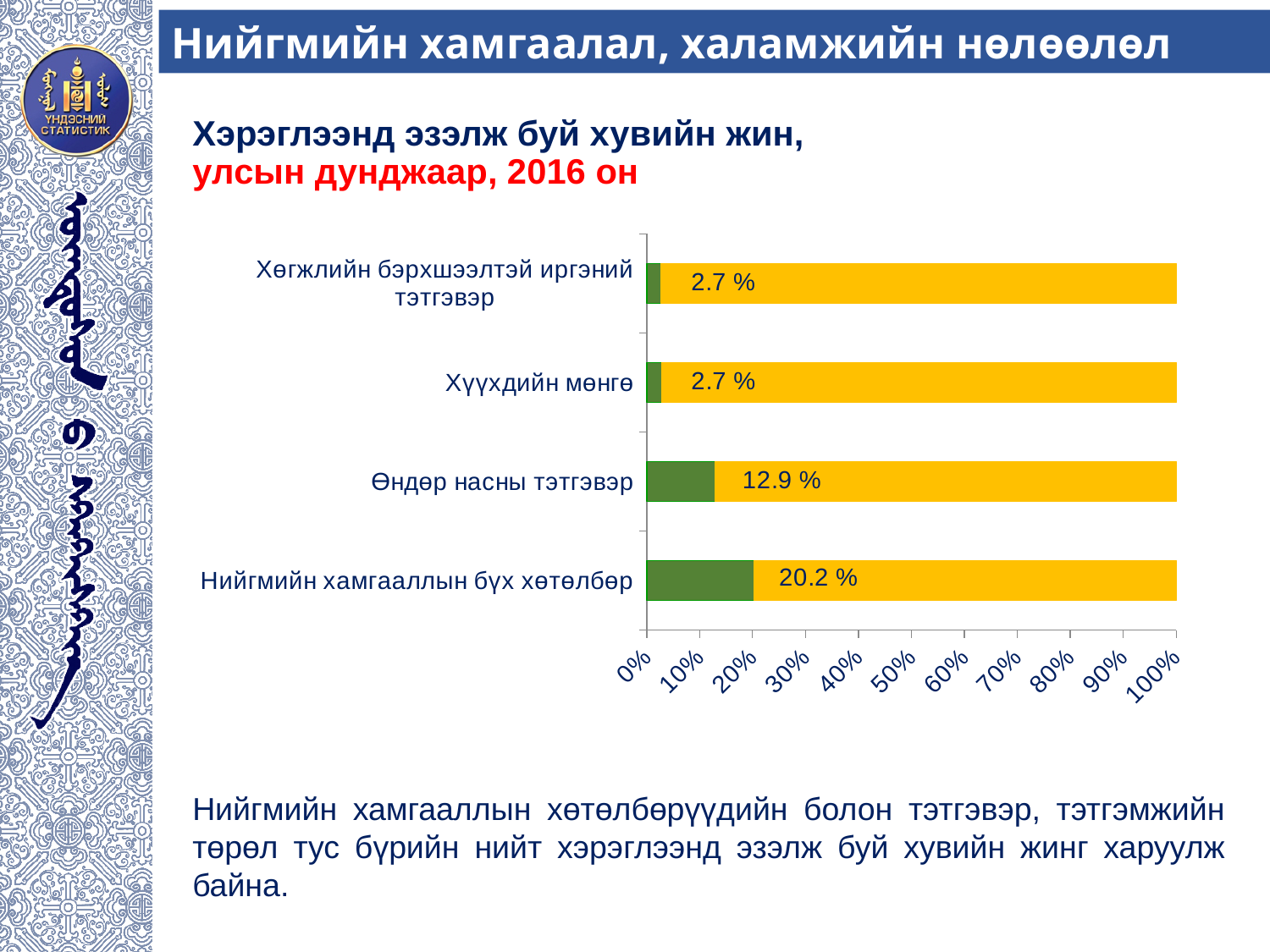
Is the value for Өндөр насны тэтгэвэр greater or less than 20%? less What is the difference between the values for Нийгмийн хамгааллын бүх хөтөлбөр and Өндөр насны тэтгэвэр? 7.3 % What is the value shown for Хүүхдийн мөнгө? 2.7 % Which year does the chart title say the data refers to? 2016 What is the value shown for Хөгжлийн бэрхшээлтэй иргэний тэтгэвэр? 2.7 % What kind of chart is shown on the slide? bar chart What is the difference between the values for Өндөр насны тэтгэвэр and Хүүхдийн мөнгө? 10.2 % Which category has the highest labelled value? Нийгмийн хамгааллын бүх хөтөлбөр What is the value shown for Өндөр насны тэтгэвэр? 12.9 % What is the value shown for Нийгмийн хамгааллын бүх хөтөлбөр? 20.2 % Which is larger, the value for Өндөр насны тэтгэвэр or the value for Хүүхдийн мөнгө? Өндөр насны тэтгэвэр How many categories are shown in the chart? 4